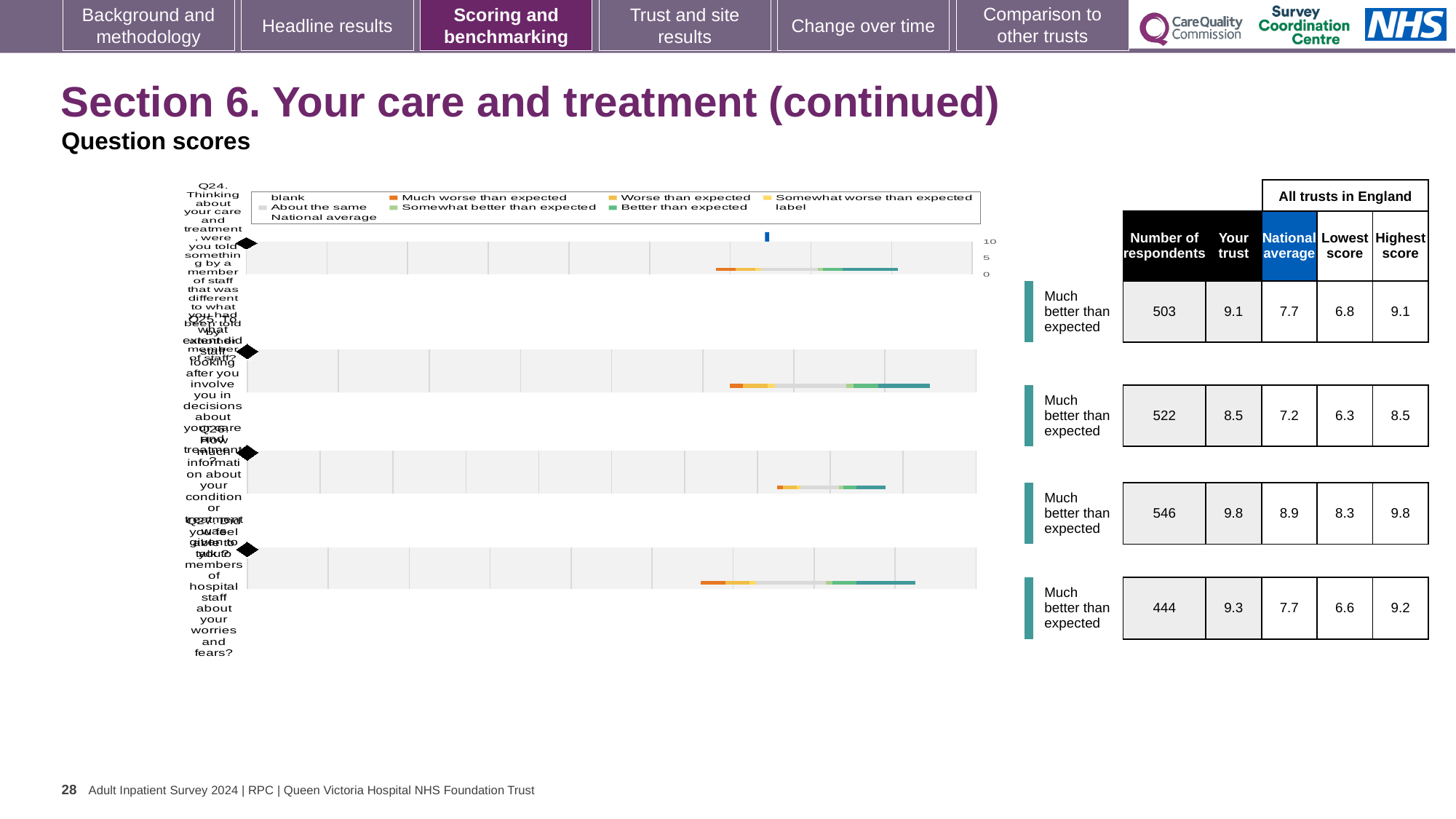
In the table, which row has the highest 'Your trust' score? the third row (9.8) In the fourth row of the table, which is larger: the 'Your trust' score or the national average? Your trust How many question rows (charts) are shown in the question scores area? 4 In the table, what is the 'Your trust' score in the first row (503 respondents)? 9.1 What kind of chart is used for the question scores on the left of the slide? bar chart In the table, what is the national average in the second row (522 respondents)? 7.2 What is the highest score in the fourth row of the table? 9.2 What rating label is shown next to each of the four question rows? Much better than expected What is the maximum value shown on the score axis of the charts? 10 In the table, which row has the lowest number of respondents? the fourth row (444) What is the lowest score in the third row of the table? 8.3 In the table, what is the difference between 'Your trust' and the national average in the first row? 1.4